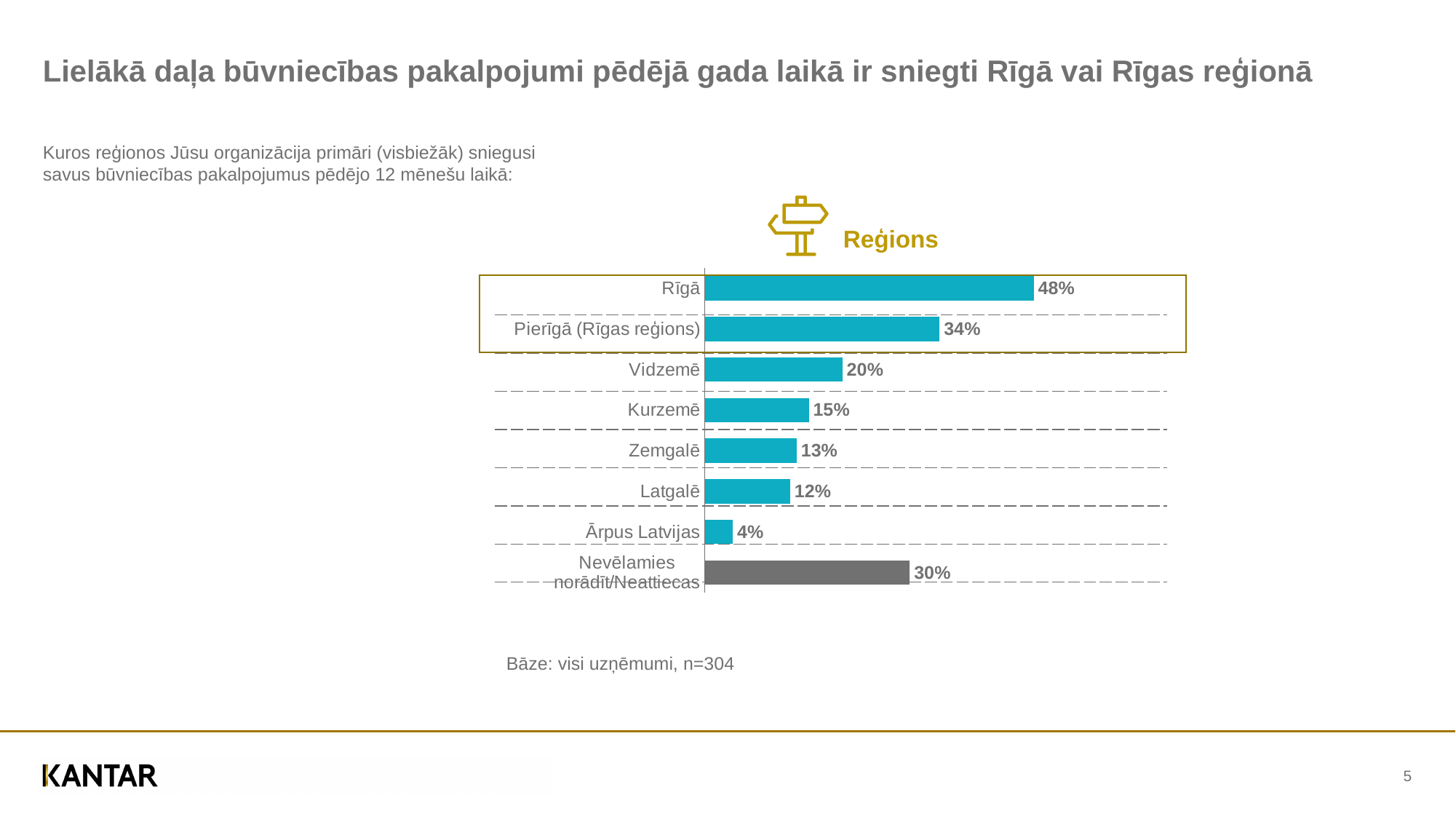
What is the difference between the values for Vidzemē and Latgalē? 8% What is the value for Pierīgā (Rīgas reģions)? 34% Which category has the lowest value? Ārpus Latvijas What is the difference between the values for Rīgā and Pierīgā (Rīgas reģions)? 14% How many categories are shown in the chart? 8 Which category has the highest value? Rīgā What is the value for Kurzemē? 15% What is the value for Rīgā? 48% Which is larger, the value for Zemgalē or the value for Latgalē? Zemgalē What is the value for Nevēlamies norādīt/Neattiecas? 30% Which category's bar is shown in grey rather than teal? Nevēlamies norādīt/Neattiecas What kind of chart is shown on the slide? Bar chart